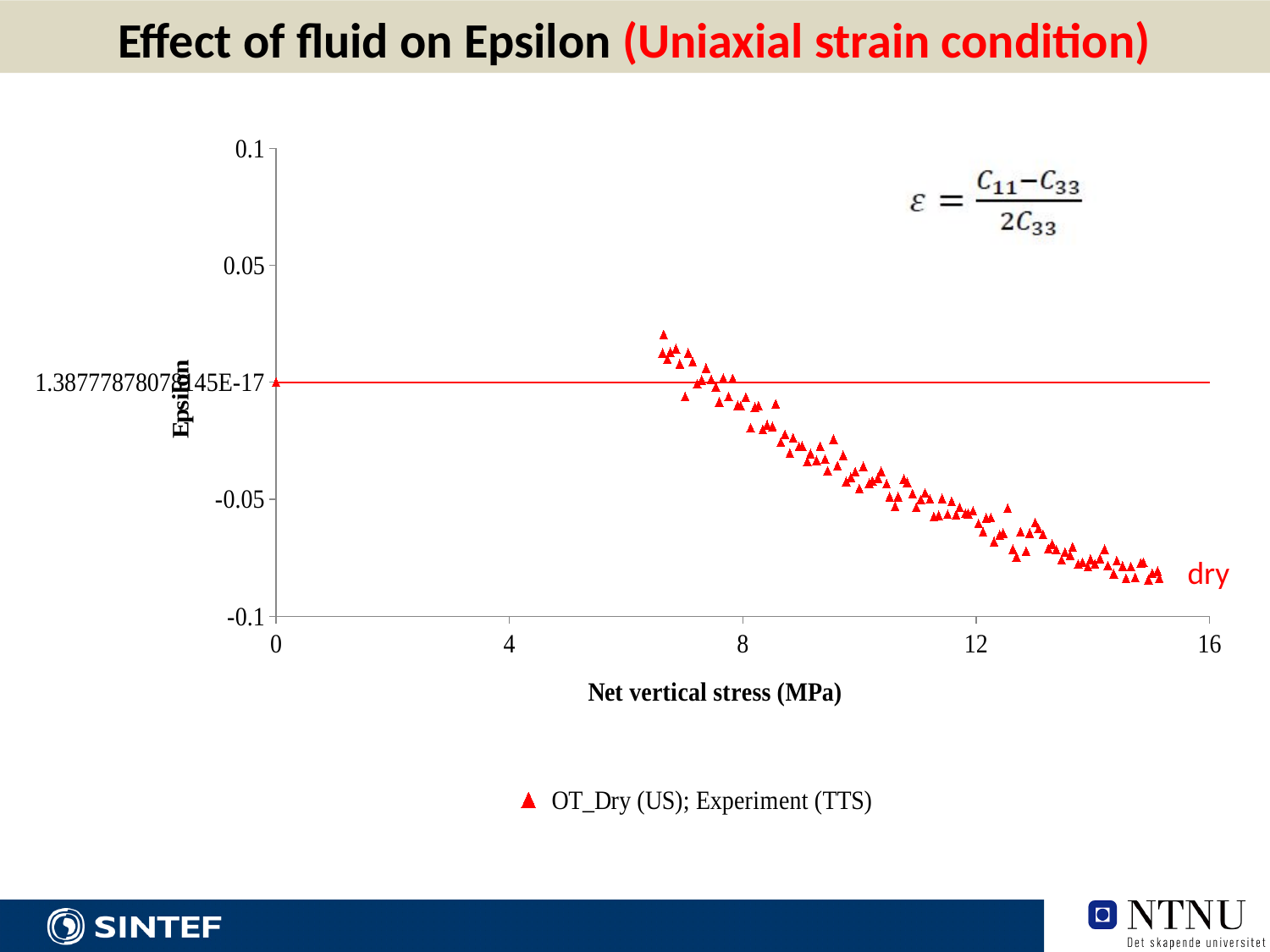
Is the Epsilon value at a net vertical stress of 7 MPa greater or less than -0.05? greater What kind of chart is shown on the slide? scatter chart Is the Epsilon value at a net vertical stress of 14 MPa greater or less than -0.05? less What is the label of the series in the legend? OT_Dry (US); Experiment (TTS) Is the Epsilon value at a net vertical stress of 7 MPa greater or less than 0.05? less What is the x-axis title of the chart? Net vertical stress (MPa) What is the maximum value shown on the x axis? 16 How many series does the legend list? 1 Do the Epsilon values rise or fall as net vertical stress increases? fall